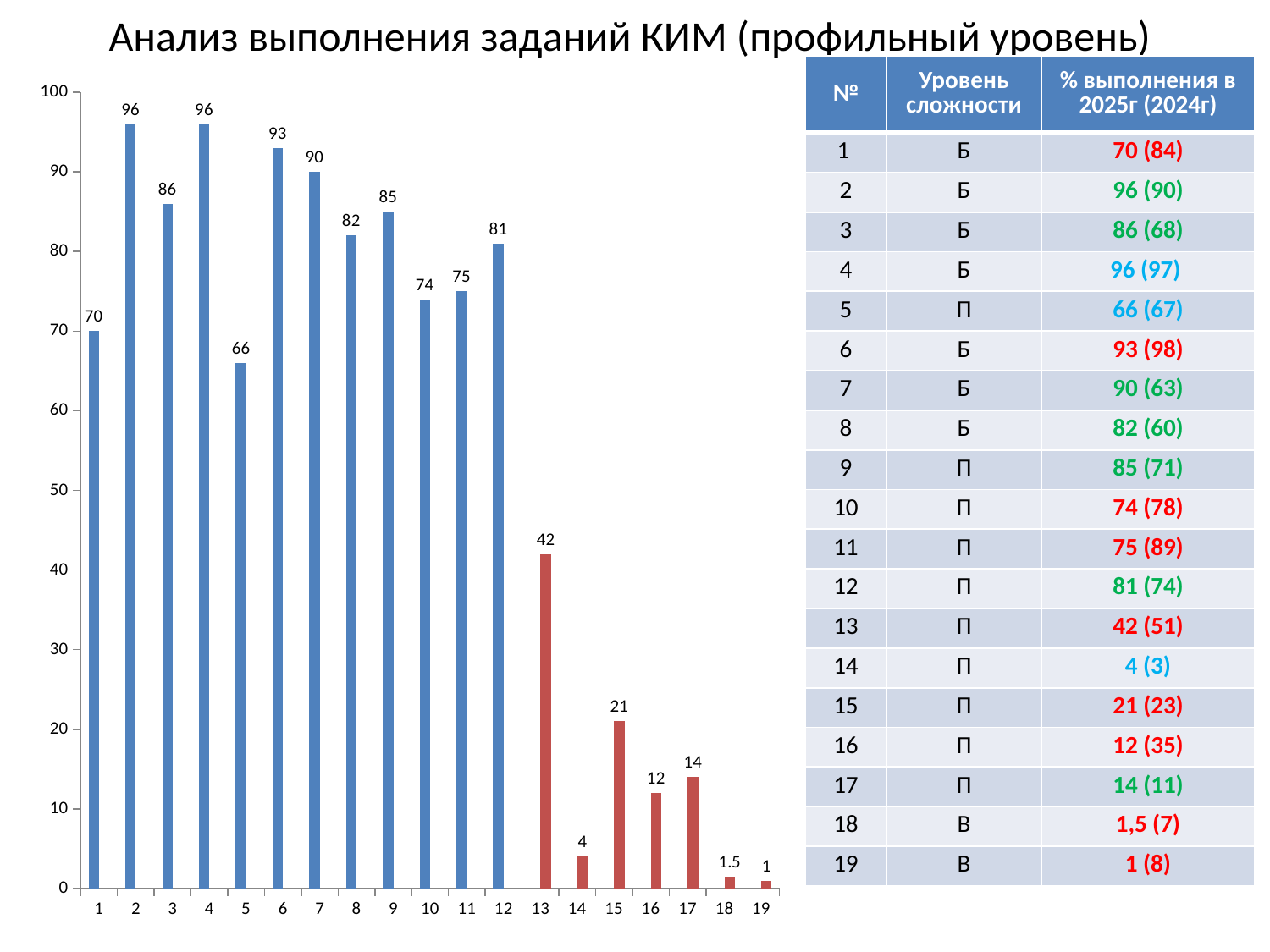
Which category has the lowest value? 19 What is the value for category 5? 66 Which is larger, the value for category 3 or the value for category 7? category 7 Is the value for category 12 greater or less than 80? greater Which is larger, the value for category 14 or the value for category 17? category 17 How many categories are shown on the x axis of the chart? 19 What is the difference between the values for category 2 and category 1? 26 What is the value for category 13? 42 What is the value for category 18? 1.5 What kind of chart is shown on the slide? bar chart What is the difference between the values for category 15 and category 16? 9 What colour are the bars for categories 13 to 19? red